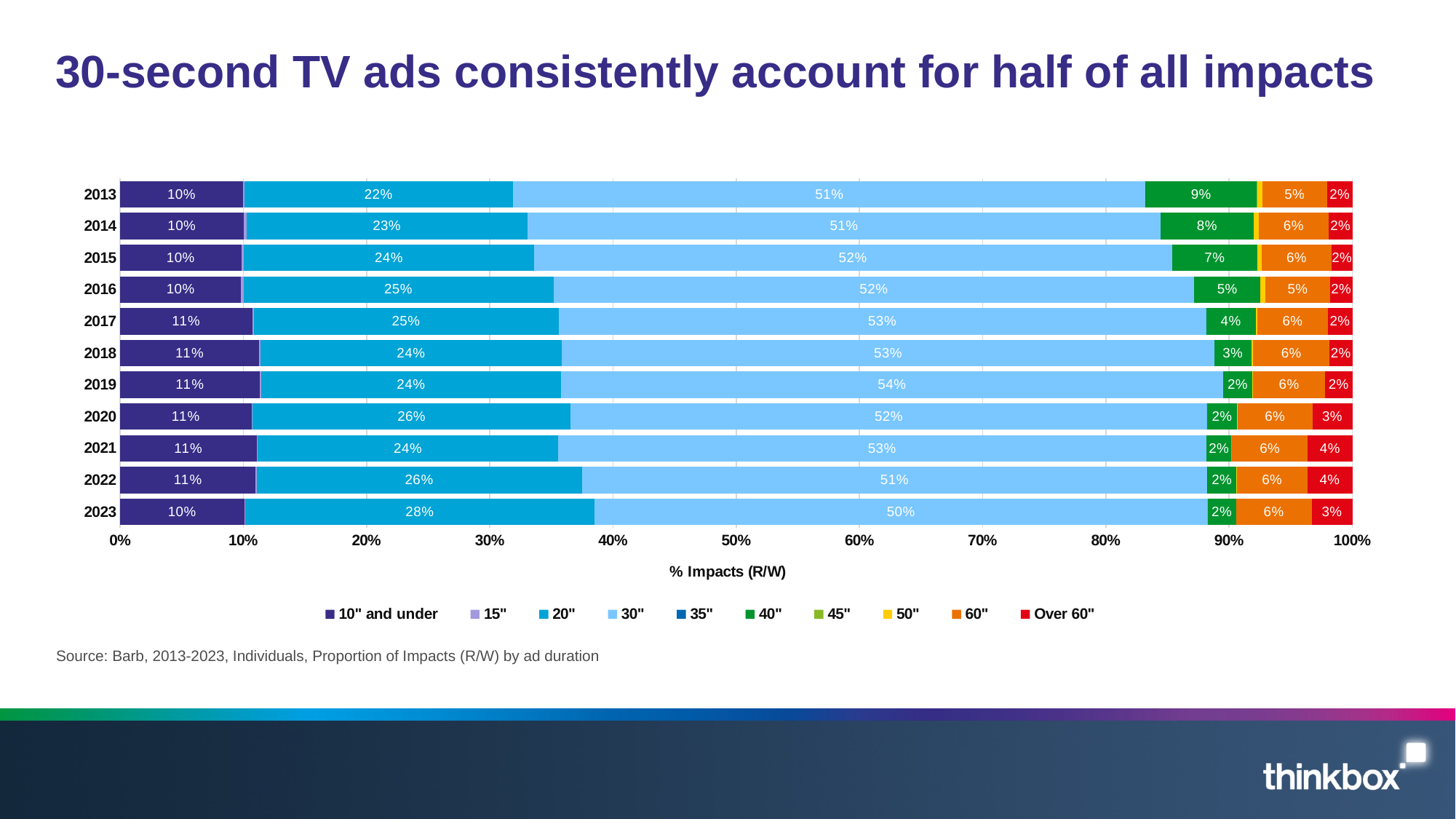
What is the value for Over 60" ads in 2021? 4% In which year did 20" ads have their highest share of impacts? 2023 How many years are shown on the chart? 11 Which year had a larger share for 30" ads, 2017 or 2023? 2017 By how many percentage points did the 40" share fall from 2013 to 2019? 7 percentage points How many ad duration series does the legend list? 10 In which year did 30" ads have their lowest share of impacts? 2023 What share of impacts did 40" ads have in 2013? 9% What percentage of impacts did 30" ads account for in 2019? 54% In which year did 30" ads have their highest share of impacts? 2019 What is the value for 20" ads in 2023? 28% What kind of chart is shown on the slide? Stacked bar chart